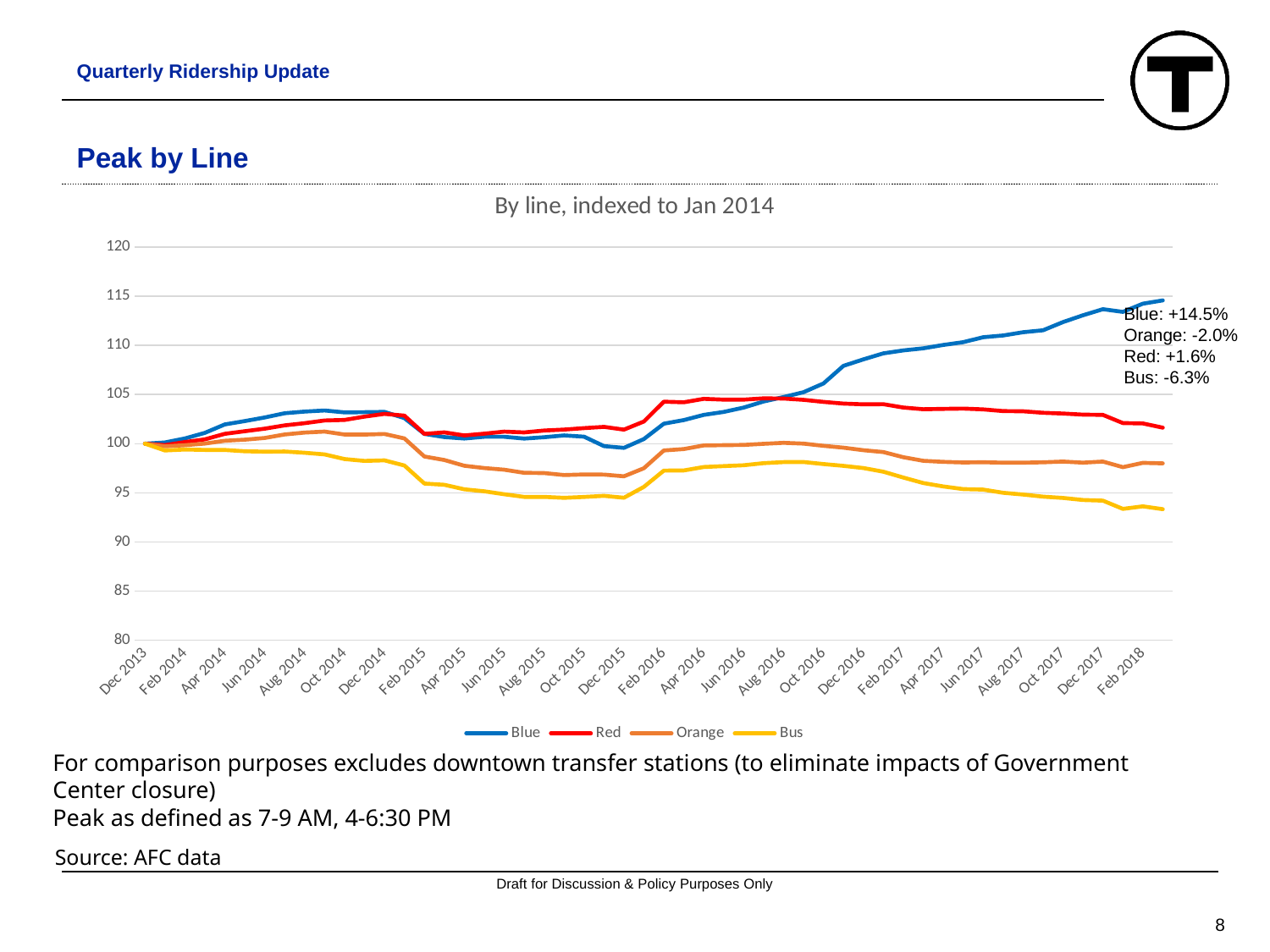
Which series has the highest value at Feb 2018? Blue Does the Bus line generally rise or fall from Dec 2013 to Feb 2018? fall What percentage change is annotated for the Red line? +1.6% What percentage change is annotated for the Blue line? +14.5% Is the value for Blue at Feb 2018 greater or less than 110? greater How many series does the legend list? 4 Which series has the lowest value at Feb 2018? Bus What is the title of the chart? By line, indexed to Jan 2014 What kind of chart is shown on the slide? line chart What percentage change is annotated for the Bus line? -6.3% Is the value for Bus at Feb 2018 greater or less than 95? less What percentage change is annotated for the Orange line? -2.0%